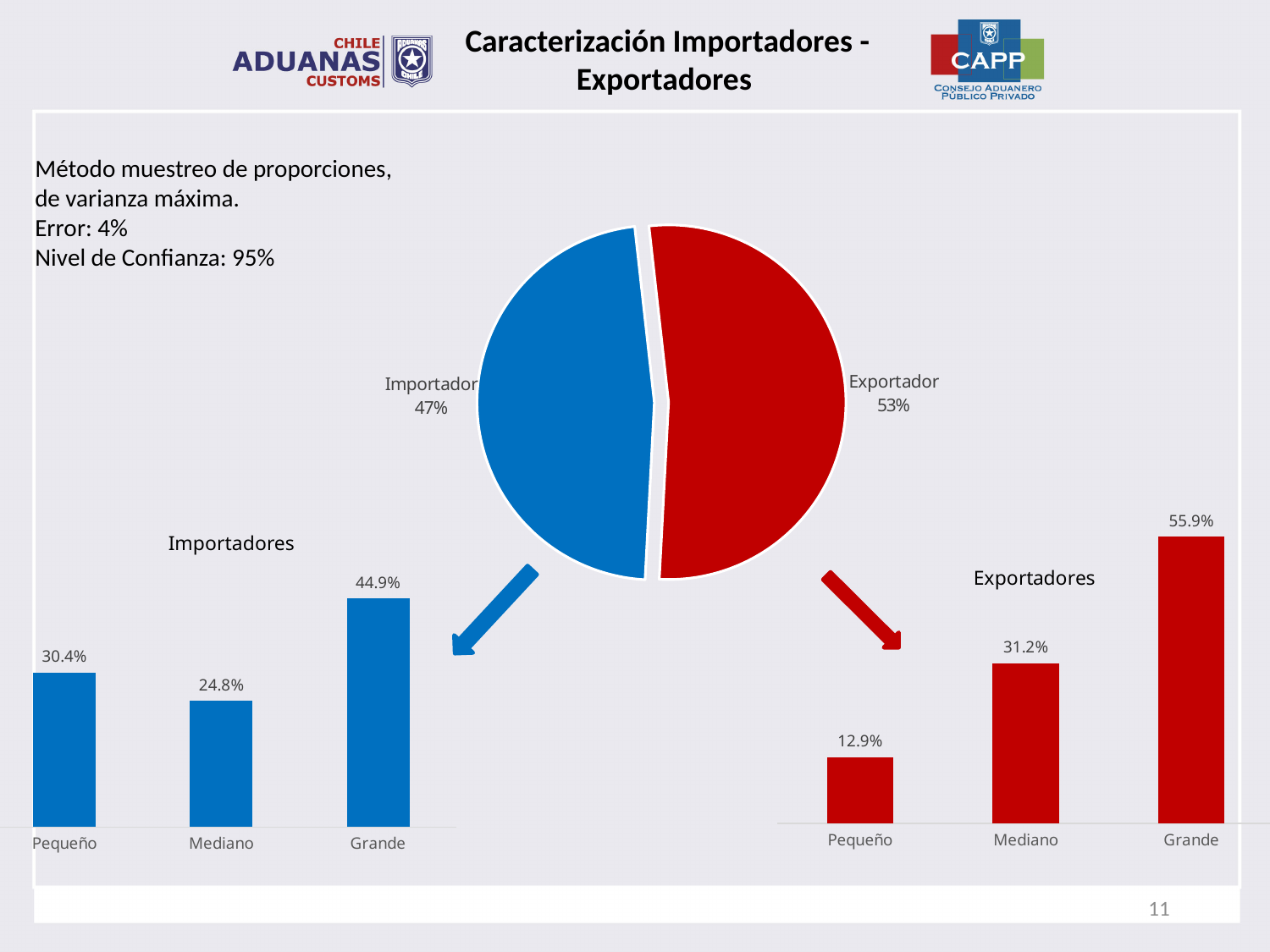
In the Exportadores bar chart, do the values rise or fall from Pequeño to Grande? rise In the Exportadores bar chart, what is the difference between Grande and Mediano? 24.7% In the pie chart, which slice is larger, Importador or Exportador? Exportador How many categories does the Importadores bar chart show? 3 In the pie chart, what share is labelled for Importador? 47% In the Exportadores bar chart, what is the value for Pequeño? 12.9% In the Importadores bar chart, which category has the lowest value? Mediano In the pie chart, what share is labelled for Exportador? 53% In the Importadores bar chart, what is the difference between Grande and Pequeño? 14.5% In the Importadores bar chart, what is the value for Mediano? 24.8% In the Importadores bar chart, what is the value for Grande? 44.9% In the Exportadores bar chart, which category has the highest value? Grande